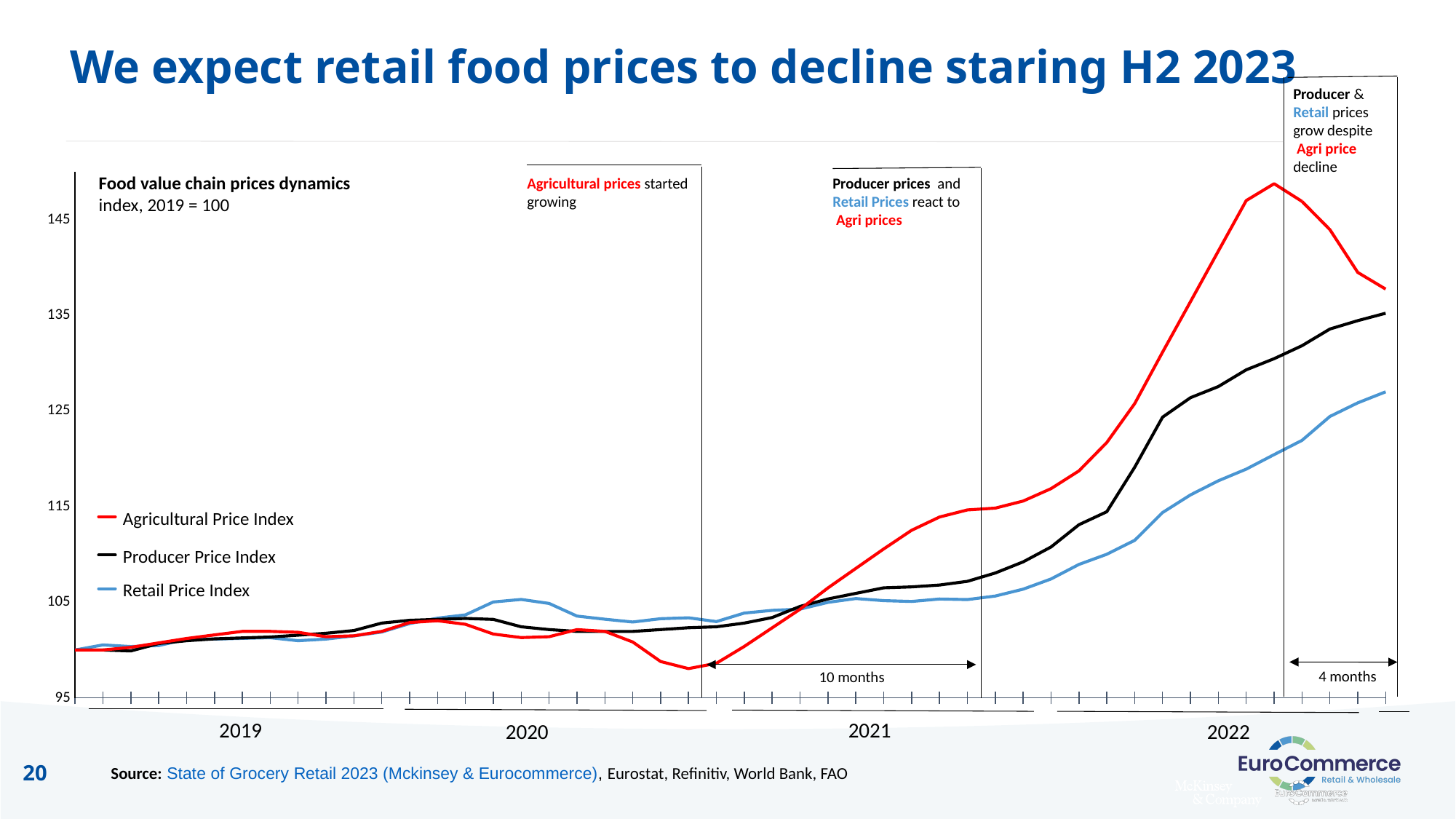
Which series is drawn in red in the chart? Agricultural Price Index At the end of 2022, which is higher: the Agricultural Price Index or the Retail Price Index? Agricultural Price Index Which series reaches the highest value anywhere on the chart? Agricultural Price Index What kind of chart is shown on the slide? line chart How many years are labelled along the x axis of the chart? 4 Is the value of the Retail Price Index at the end of 2022 greater or less than 125? greater What is the title of the chart? Food value chain prices dynamics Does the Retail Price Index rise or fall over the course of 2022? rise Is the lowest value of the Agricultural Price Index in 2020 greater or less than 105? less Is the peak value of the Agricultural Price Index in 2022 greater or less than 145? greater How many series does the chart legend list? 3 Which series has the lowest value at the end of 2022? Retail Price Index